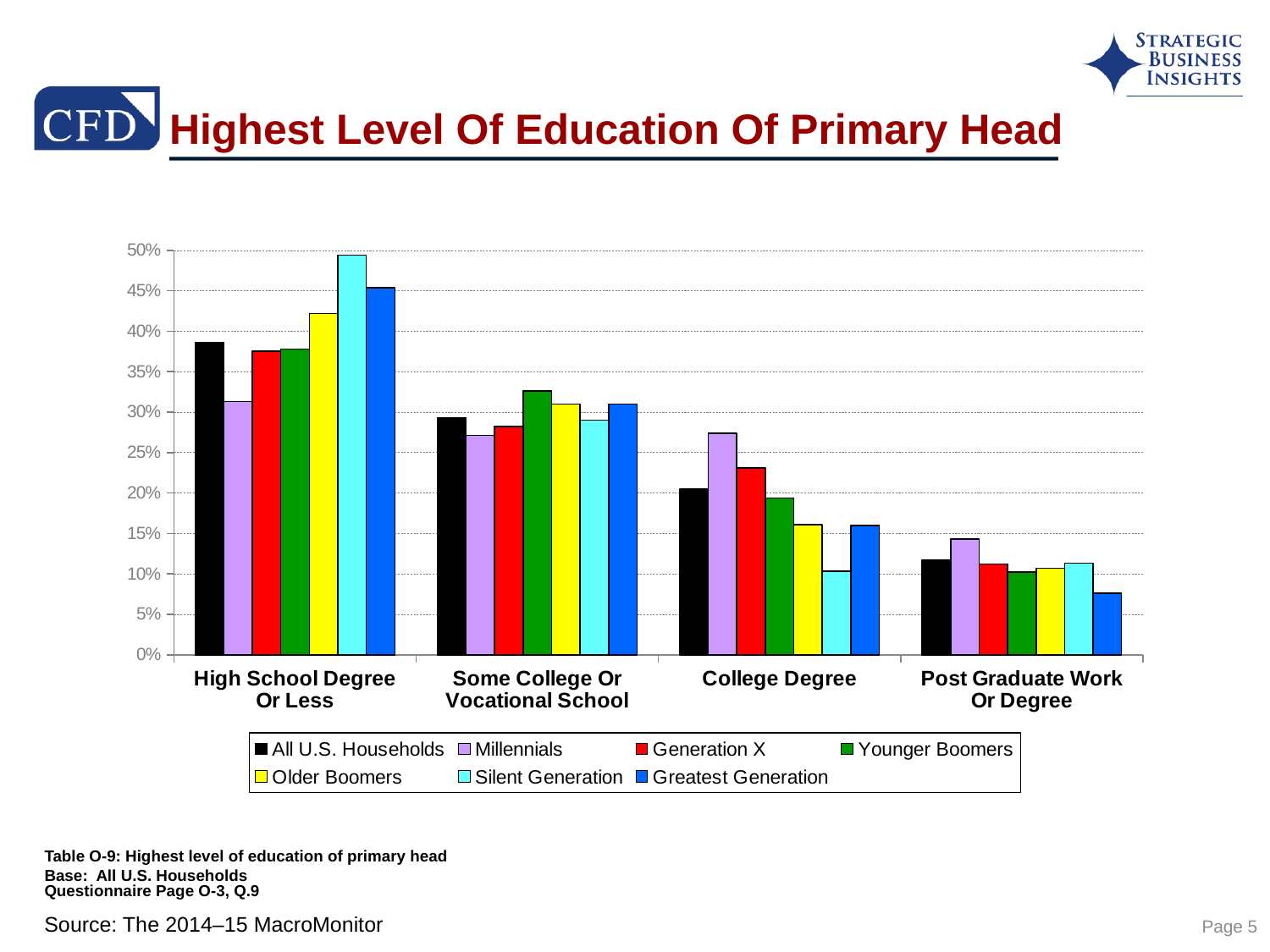
Which series has the highest value for College Degree? Millennials Which series has the lowest value for College Degree? Silent Generation Which series has the highest value for High School Degree Or Less? Silent Generation How many series does the legend list? 7 For College Degree, which is larger: Millennials or Generation X? Millennials How many education categories are shown on the x axis? 4 What kind of chart is shown on the slide? bar chart Which series has the lowest value for Post Graduate Work Or Degree? Greatest Generation Is the value for Millennials in College Degree greater or less than 25%? greater Which series has the lowest value for High School Degree Or Less? Millennials Do the values for All U.S. Households rise or fall moving from High School Degree Or Less to Post Graduate Work Or Degree? fall Is the value for Silent Generation in High School Degree Or Less greater or less than 45%? greater